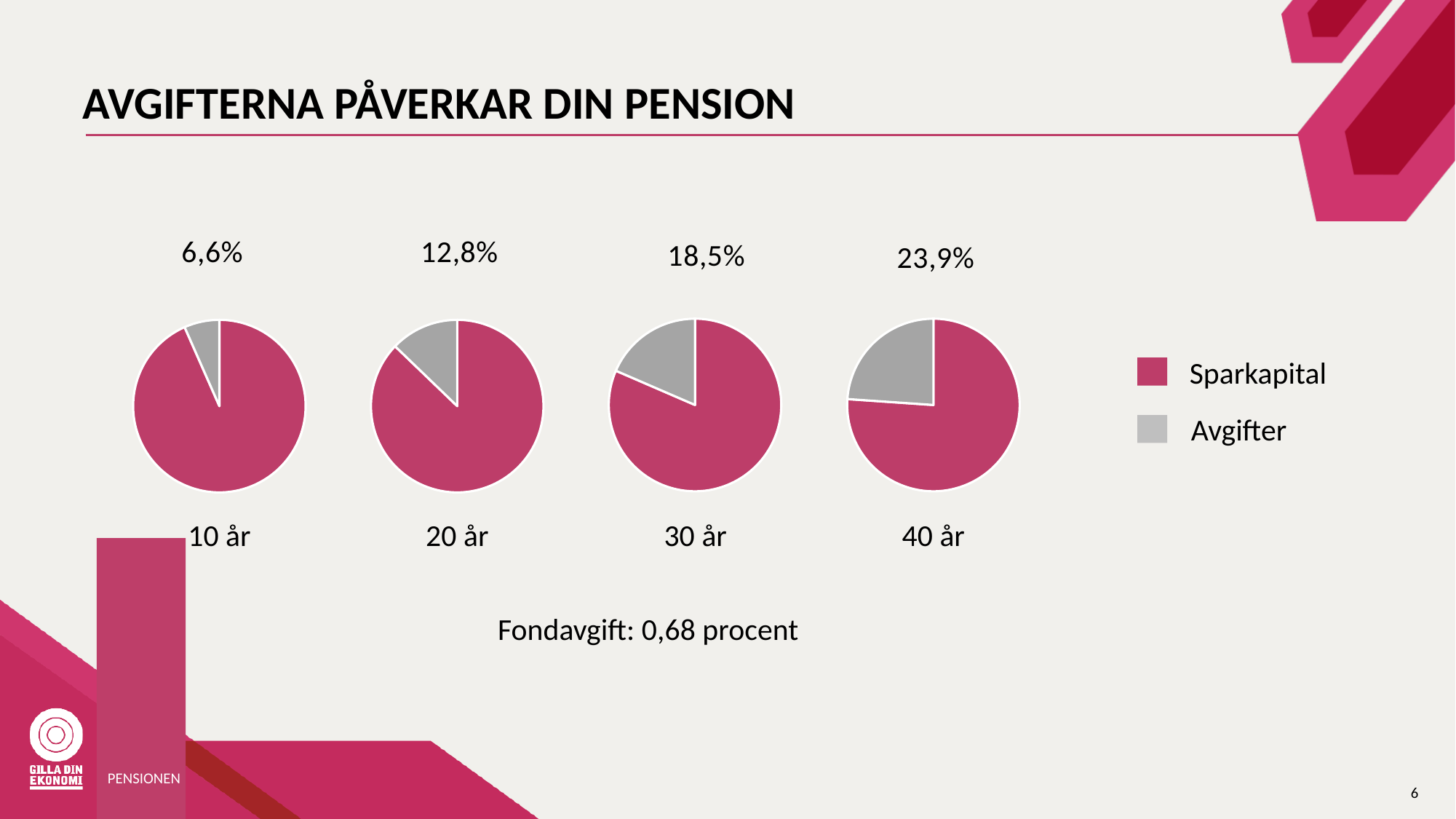
Does the Avgifter share rise or fall as the time period increases from 10 år to 40 år? Rise How many pie charts are shown on the slide? 4 What kind of charts are shown on the slide? Pie charts Which pie chart has a larger Avgifter share, the one labelled 20 år or the one labelled 30 år? 30 år Across the four pie charts, which time period has the smallest Avgifter share? 10 år In the pie chart labelled 40 år, what percentage is shown for the Avgifter slice? 23,9% In the pie chart labelled 30 år, what percentage is shown for the Avgifter slice? 18,5% In the pie chart labelled 20 år, what percentage is shown for the Avgifter slice? 12,8% How many entries does the legend list? 2 Across the four pie charts, which time period has the largest Avgifter share? 40 år In the pie chart labelled 10 år, what percentage is shown for the Avgifter slice? 6,6% What is the difference between the Avgifter percentage in the 40 år pie chart and the 10 år pie chart? 17,3%